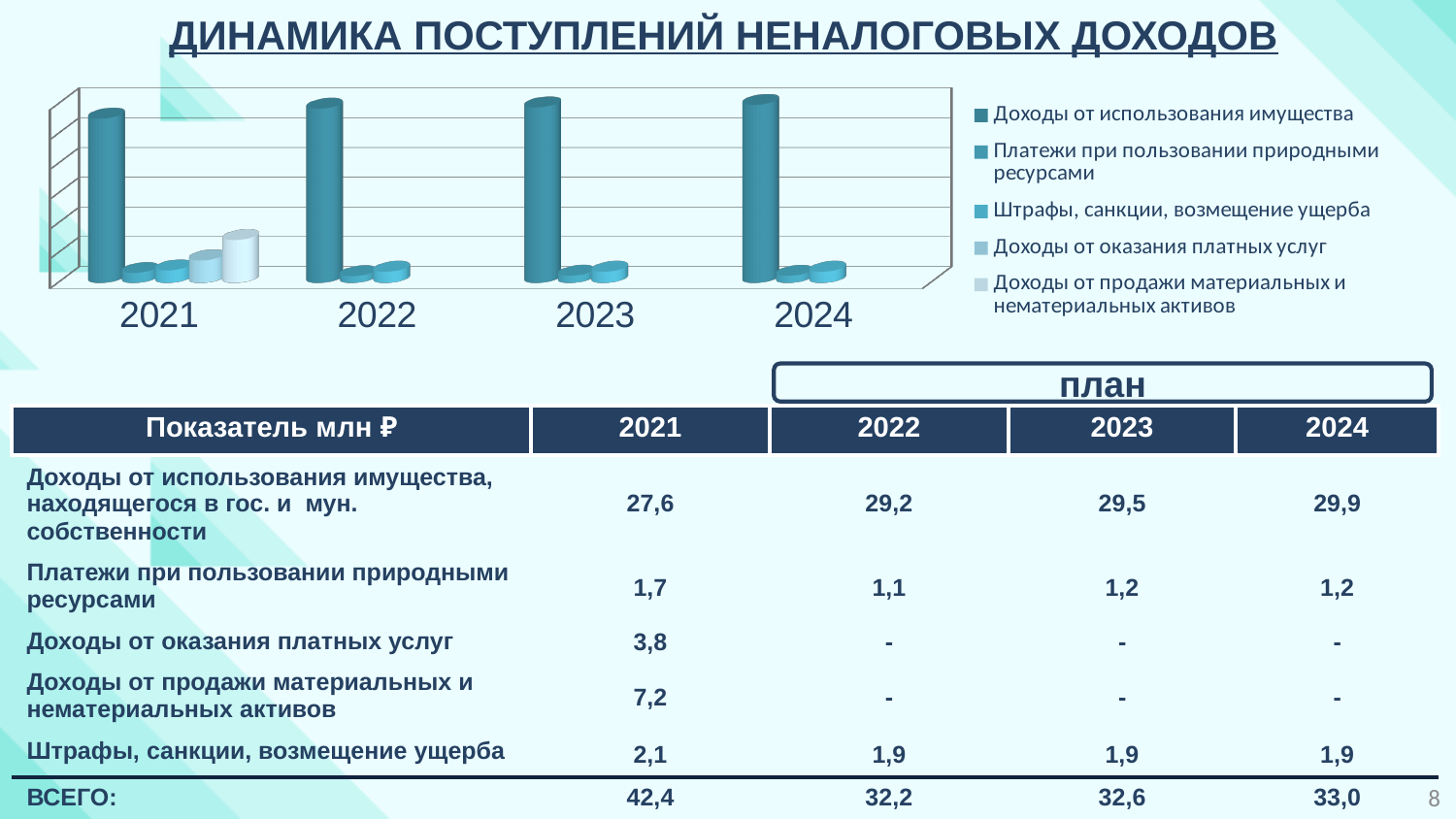
Which series has the highest value in 2021? Доходы от использования имущества What is the value for "Платежи при пользовании природными ресурсами" in 2022? 1,1 What is the difference between the 2024 and 2021 values for "Доходы от использования имущества"? 2,3 What is the value for "Доходы от использования имущества" in 2021? 27,6 How many series does the chart legend list? 5 How many years (categories) are shown on the x axis of the chart? 4 Does the value for "Доходы от использования имущества" rise or fall from 2021 to 2024? rise What kind of chart is shown on the slide? bar chart What is the value for "Доходы от использования имущества" in 2024? 29,9 Which is larger in 2021: "Доходы от продажи материальных и нематериальных активов" or "Доходы от оказания платных услуг"? Доходы от продажи материальных и нематериальных активов Which series has the lowest value in 2021? Платежи при пользовании природными ресурсами What is the value for "Штрафы, санкции, возмещение ущерба" in 2023? 1,9